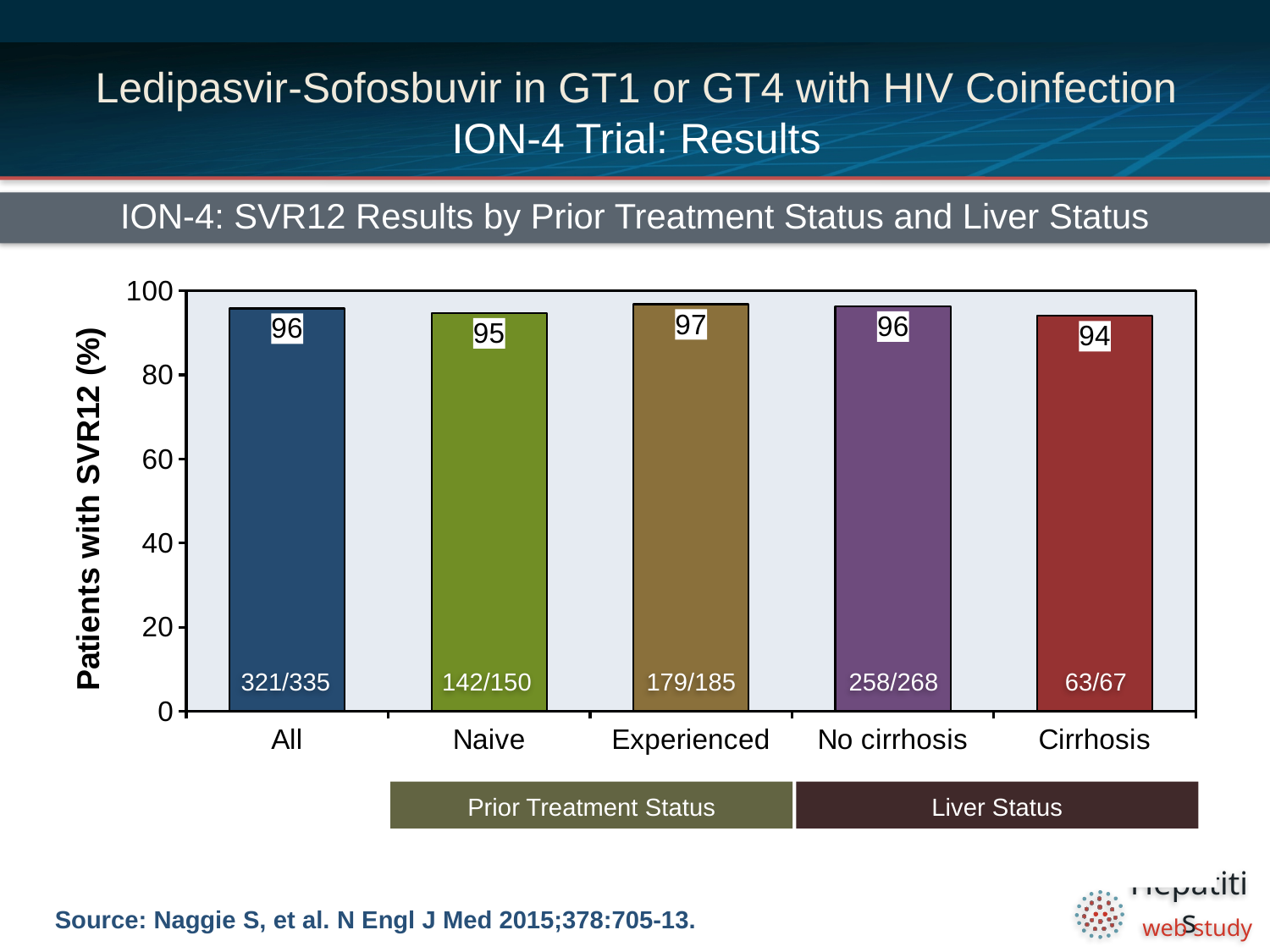
Which has a higher SVR12 rate, Naive or Experienced? Experienced What is the SVR12 rate for the Experienced group? 97 What fraction of patients is shown for the Naive group? 142/150 What is the SVR12 rate for the Cirrhosis group? 94 What is the difference in SVR12 rate between the Experienced and Cirrhosis groups? 3 What is the label of the y axis? Patients with SVR12 (%) Which group has the lowest SVR12 rate? Cirrhosis What kind of chart is shown on the slide? Bar chart How many groups are shown on the x axis? 5 What is the SVR12 rate for the All group? 96 Which group has the highest SVR12 rate? Experienced What fraction of patients is shown for the No cirrhosis group? 258/268